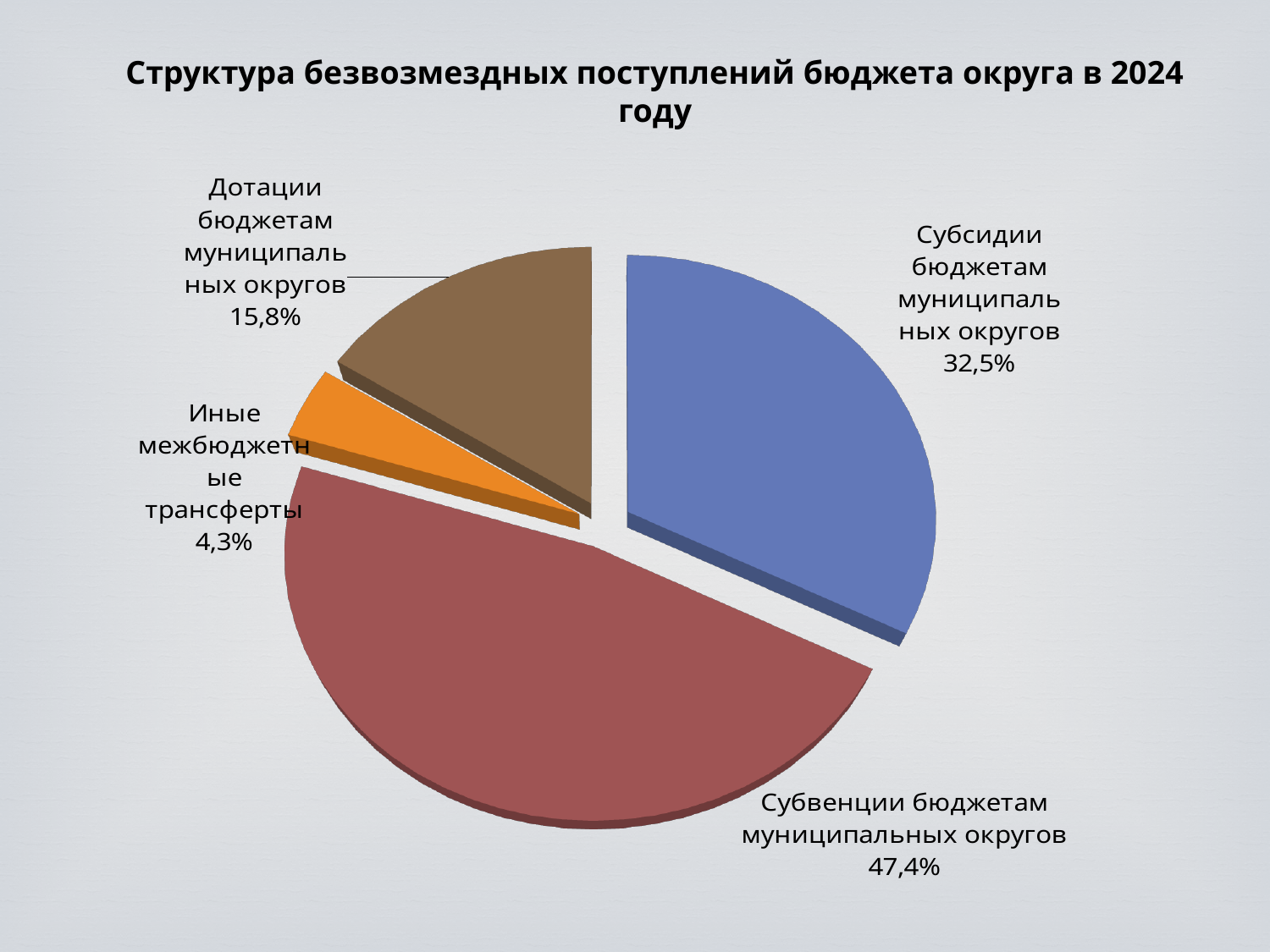
Каким цветом показан сектор субвенций бюджетам муниципальных округов? Красным Что больше: доля дотаций или доля иных межбюджетных трансфертов? Доля дотаций Какова доля субсидий бюджетам муниципальных округов? 32,5% Сколько категорий показано на диаграмме? 4 Какова доля иных межбюджетных трансфертов? 4,3% Какова доля субвенций бюджетам муниципальных округов? 47,4% Какова доля дотаций бюджетам муниципальных округов? 15,8% На сколько процентных пунктов доля субвенций больше доли субсидий? 14,9 Как называется диаграмма на слайде? Структура безвозмездных поступлений бюджета округа в 2024 году Какая категория имеет наименьшую долю? Иные межбюджетные трансферты Какая категория имеет наибольшую долю? Субвенции бюджетам муниципальных округов Какой тип диаграммы показан на слайде? Круговая диаграмма